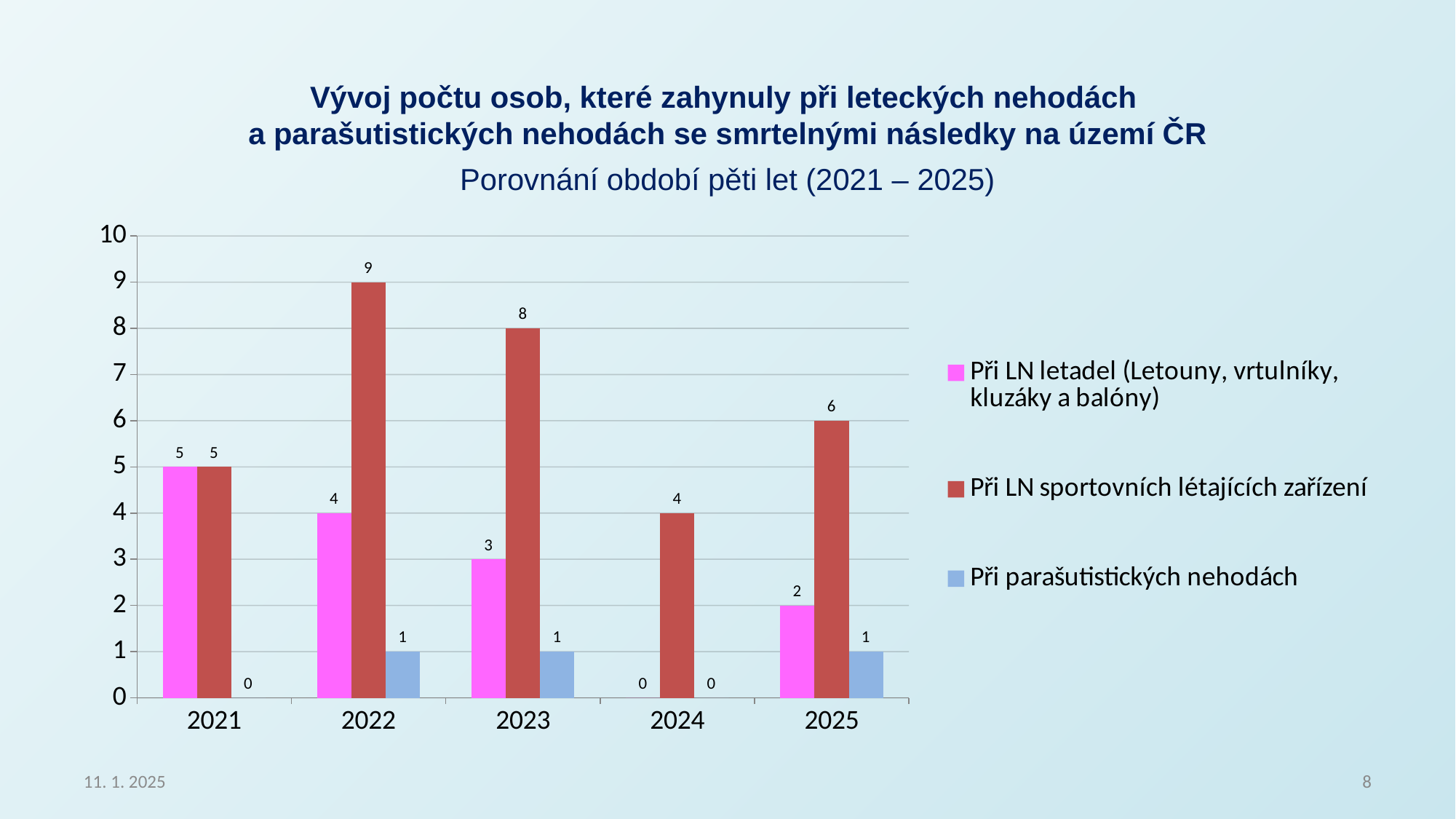
What is the value for 'Při parašutistických nehodách' in 2024? 0 In which year is the value for 'Při LN letadel (Letouny, vrtulníky, kluzáky a balóny)' lowest? 2024 What is the value for 'Při LN letadel (Letouny, vrtulníky, kluzáky a balóny)' in 2023? 3 What colour are the bars for 'Při parašutistických nehodách'? light blue Does the value for 'Při LN letadel (Letouny, vrtulníky, kluzáky a balóny)' rise or fall from 2021 to 2024? fall What is the difference between the 'Při LN sportovních létajících zařízení' values for 2022 and 2025? 3 In which year is the value for 'Při LN sportovních létajících zařízení' highest? 2022 How many years are shown on the x axis? 5 What is the value for 'Při LN sportovních létajících zařízení' in 2022? 9 What kind of chart is shown on the slide? bar chart Which is larger in 2023: the value for 'Při LN letadel (Letouny, vrtulníky, kluzáky a balóny)' or for 'Při LN sportovních létajících zařízení'? Při LN sportovních létajících zařízení How many series does the legend list? 3